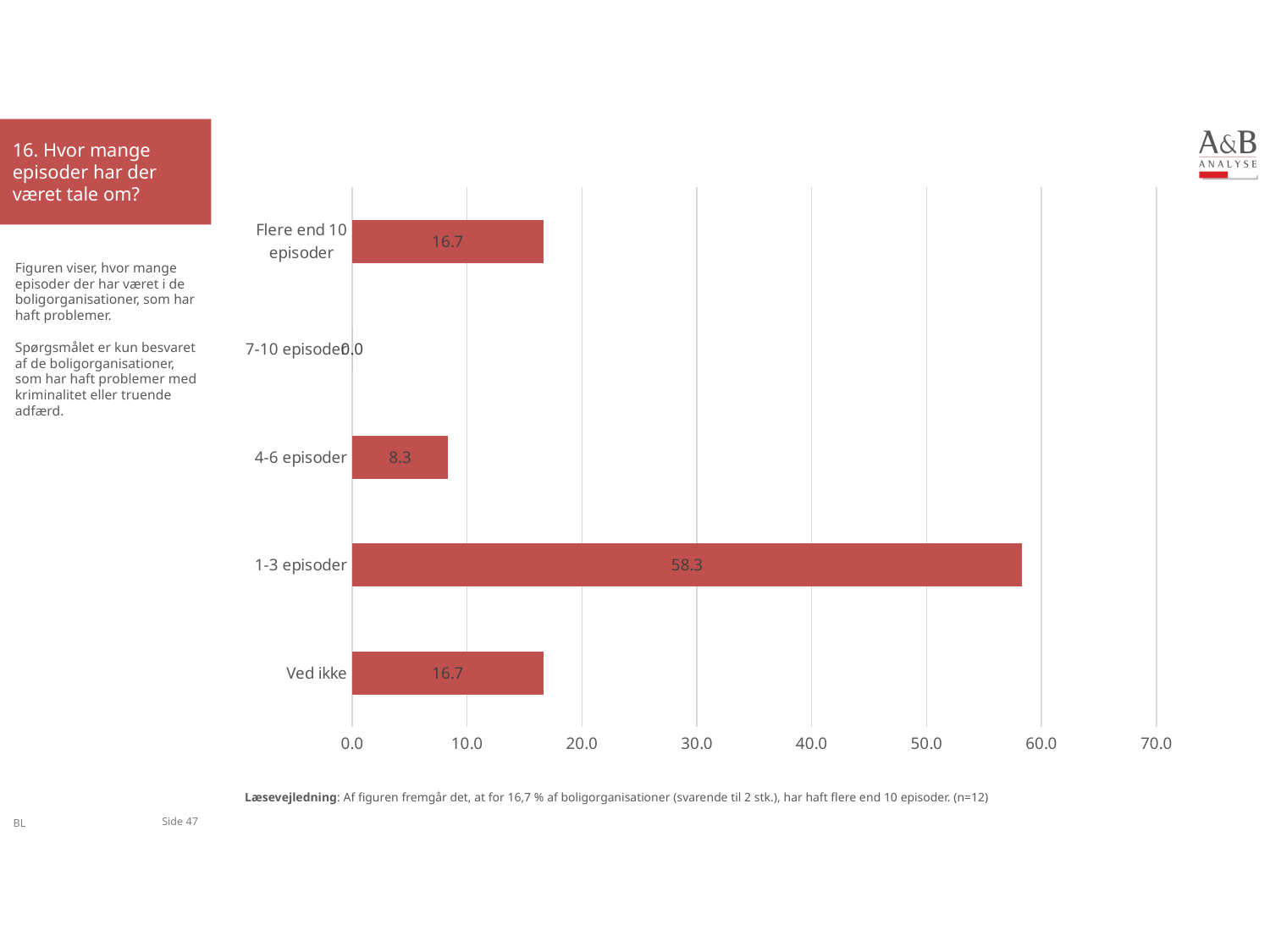
What is the value for "4-6 episoder"? 8.3 Is the value for "1-3 episoder" greater or less than 50.0? greater What is the value for "1-3 episoder"? 58.3 What is the title of the chart on the slide? 16. Hvor mange episoder har der været tale om? What is the difference between the values for "1-3 episoder" and "Ved ikke"? 41.6 What is the value for "Flere end 10 episoder"? 16.7 Which is larger, the value for "4-6 episoder" or the value for "Ved ikke"? Ved ikke What is the value for "7-10 episoder"? 0.0 Which category has the highest value? 1-3 episoder How many categories are shown in the chart? 5 Which category has the lowest value? 7-10 episoder What kind of chart is shown on the slide? bar chart